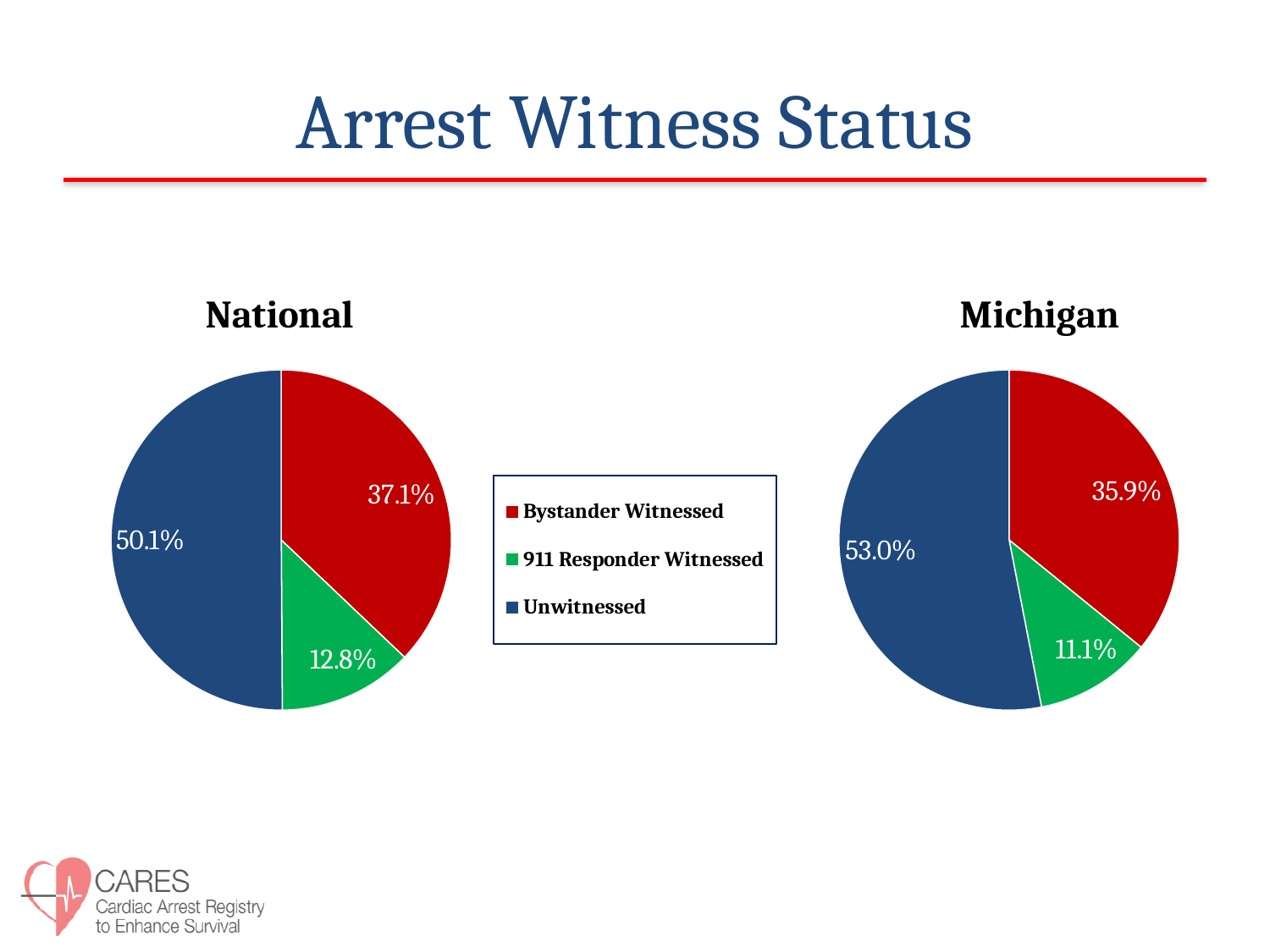
In the National pie chart, what percentage of arrests were 911 Responder Witnessed? 12.8% In the Michigan pie chart, what percentage of arrests were 911 Responder Witnessed? 11.1% Which chart shows a larger Bystander Witnessed share, National or Michigan? National In the National pie chart, which category has the largest share? Unwitnessed What is the difference between the Unwitnessed share in the Michigan chart and the Unwitnessed share in the National chart? 2.9% Which colour represents Unwitnessed in the legend? Blue What type of chart is used for the National data? Pie chart In the Michigan pie chart, what percentage of arrests were Unwitnessed? 53.0% In the National pie chart, what percentage of arrests were Bystander Witnessed? 37.1% How many entries does the legend list? 3 How many slices does the Michigan pie chart have? 3 In the Michigan pie chart, which category has the smallest share? 911 Responder Witnessed